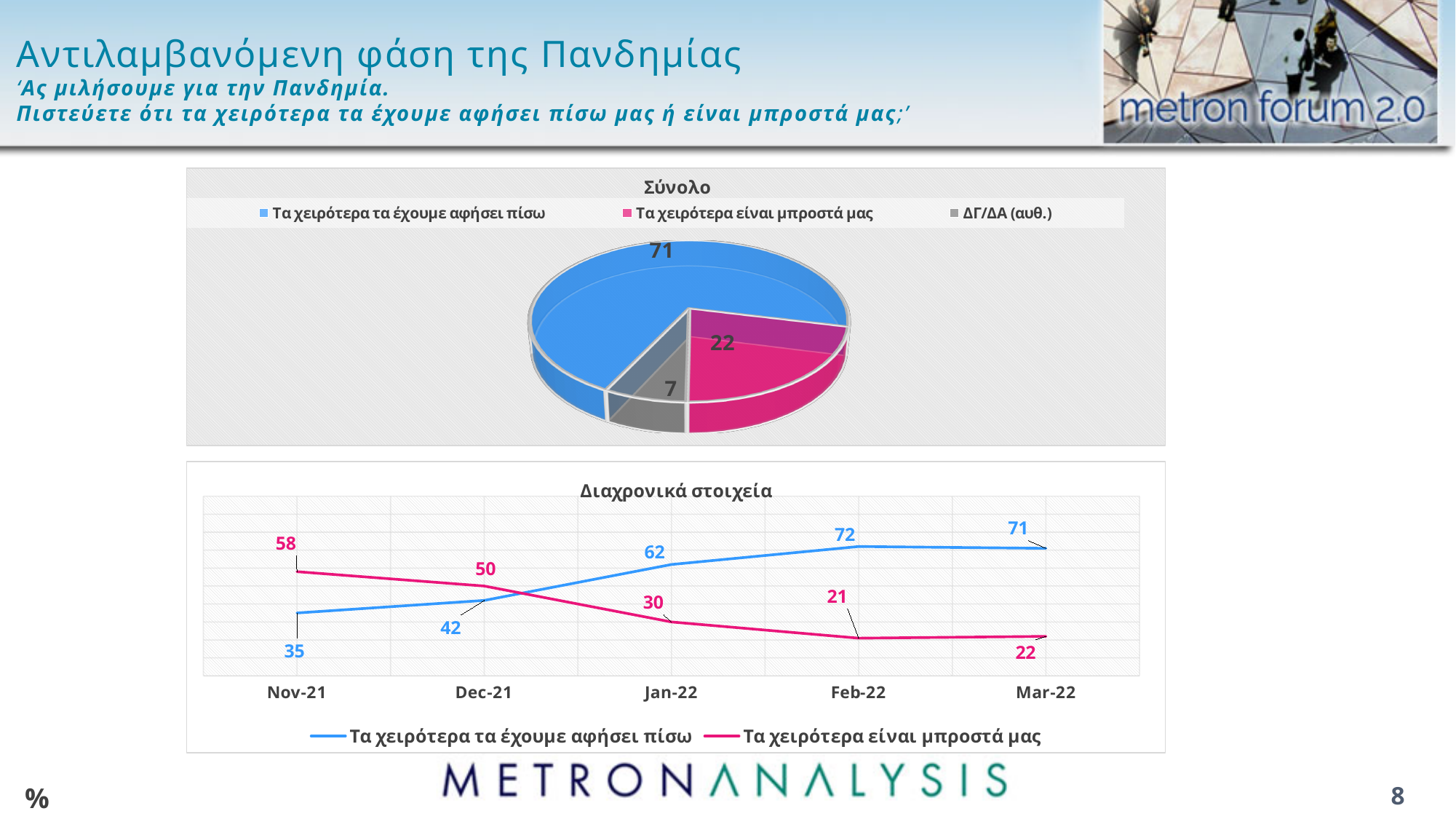
In the 'Διαχρονικά στοιχεία' chart, how many time points are shown on the x axis? 5 In the 'Διαχρονικά στοιχεία' chart, what is the value for 'Τα χειρότερα είναι μπροστά μας' in Nov-21? 58 How many series does the legend of the 'Διαχρονικά στοιχεία' chart list? 2 In the 'Διαχρονικά στοιχεία' chart, does 'Τα χειρότερα είναι μπροστά μας' generally rise or fall from Nov-21 to Mar-22? Fall In the 'Σύνολο' chart, what is the difference between 'Τα χειρότερα τα έχουμε αφήσει πίσω' and 'Τα χειρότερα είναι μπροστά μας'? 49 In the 'Σύνολο' chart, what value is shown for 'ΔΓ/ΔΑ (αυθ.)'? 7 In the 'Διαχρονικά στοιχεία' chart, what is the value for 'Τα χειρότερα τα έχουμε αφήσει πίσω' in Jan-22? 62 In the 'Σύνολο' chart, which category has the smallest slice? ΔΓ/ΔΑ (αυθ.) In the 'Σύνολο' chart, what value is shown for 'Τα χειρότερα τα έχουμε αφήσει πίσω'? 71 In the 'Διαχρονικά στοιχεία' chart, in which month does 'Τα χειρότερα τα έχουμε αφήσει πίσω' reach its highest value? Feb-22 In the 'Διαχρονικά στοιχεία' chart, which series has the larger value in Dec-21? Τα χειρότερα είναι μπροστά μας What kind of chart is the 'Σύνολο' chart? Pie chart